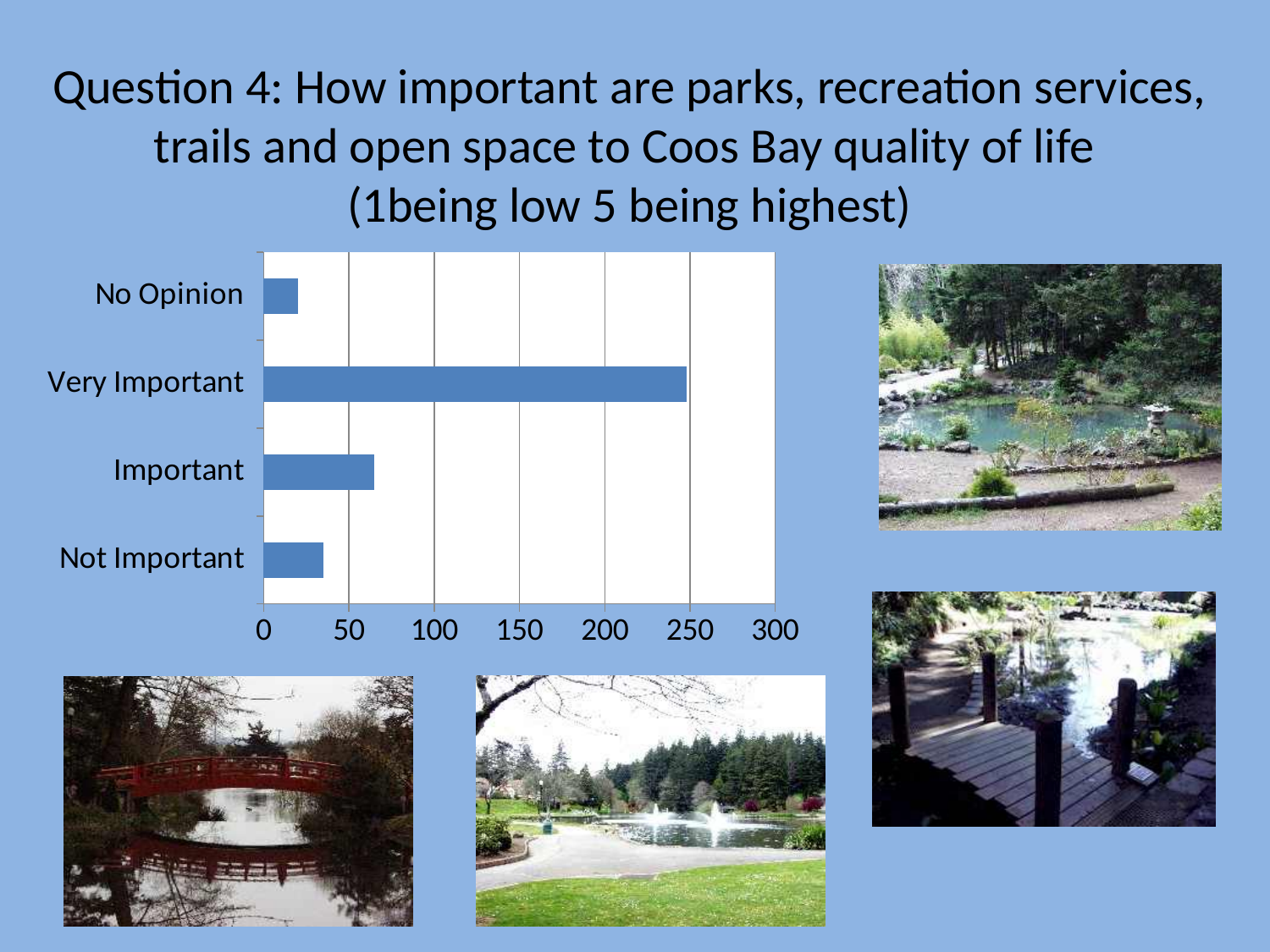
Which is larger, the value for Important or the value for Not Important? Important Is the value for Very Important greater or less than 200? greater Is the value for Not Important greater or less than 50? less Is the value for Important greater or less than 50? greater Which is larger, the value for Not Important or the value for No Opinion? Not Important What is the highest value shown on the horizontal axis of the bar chart? 300 What kind of chart is shown on the slide? bar chart Which category has the lowest value in the bar chart? No Opinion Which category has the highest value in the bar chart? Very Important How many categories are plotted in the bar chart? 4